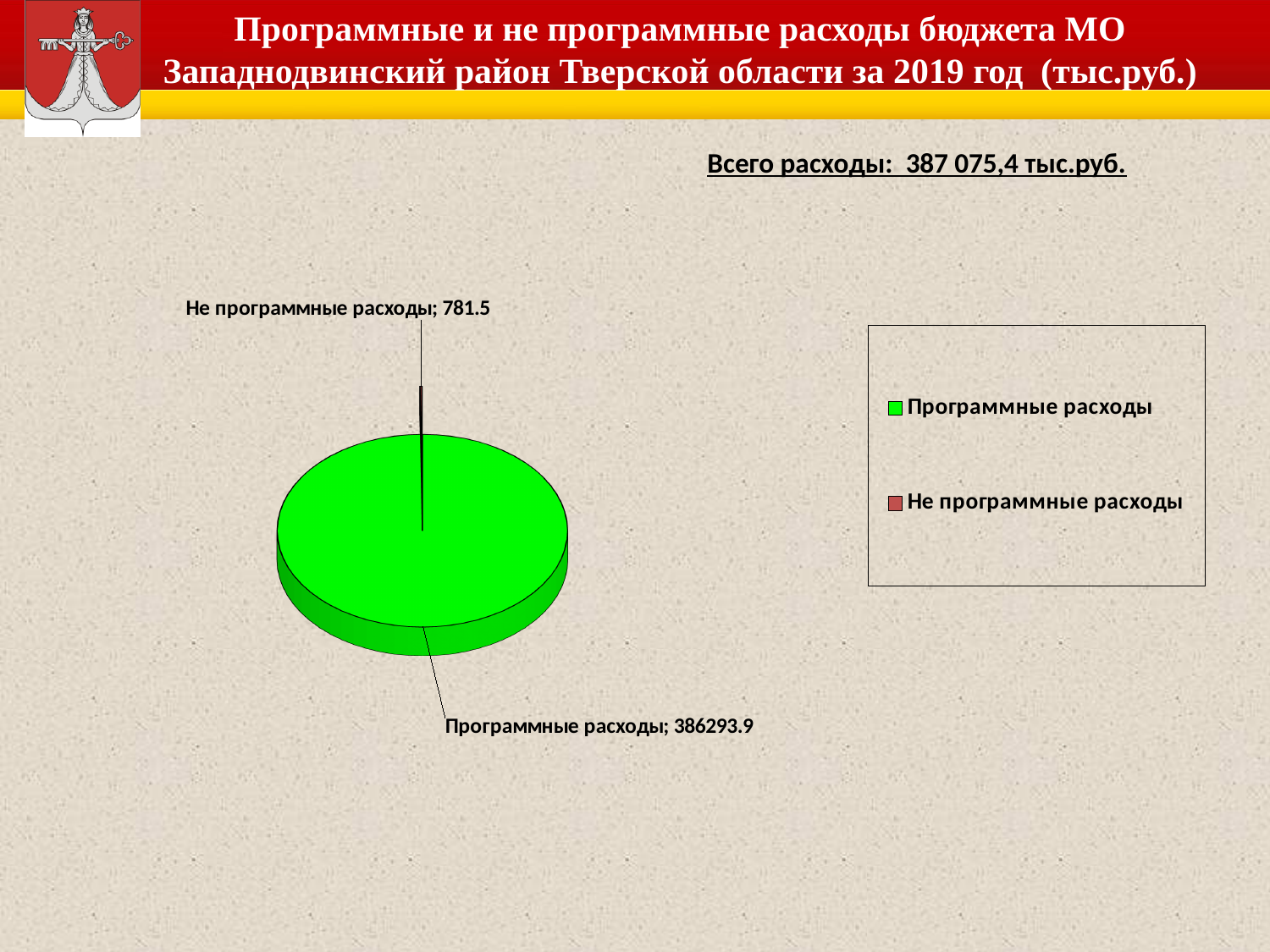
What is the value for Не программные расходы? 781.5 Which category has the smallest slice of the pie? Не программные расходы How many entries does the legend list? 2 For which year does the chart show budget expenditures? 2019 How many categories does the pie chart have? 2 Which category has the largest slice of the pie? Программные расходы Which is larger: Программные расходы or Не программные расходы? Программные расходы What colour is the Программные расходы slice? Green What total expenditure is stated on the slide? 387 075,4 тыс.руб. What is the difference between Программные расходы and Не программные расходы? 385512.4 What is the value for Программные расходы? 386293.9 What type of chart is shown on the slide? Pie chart